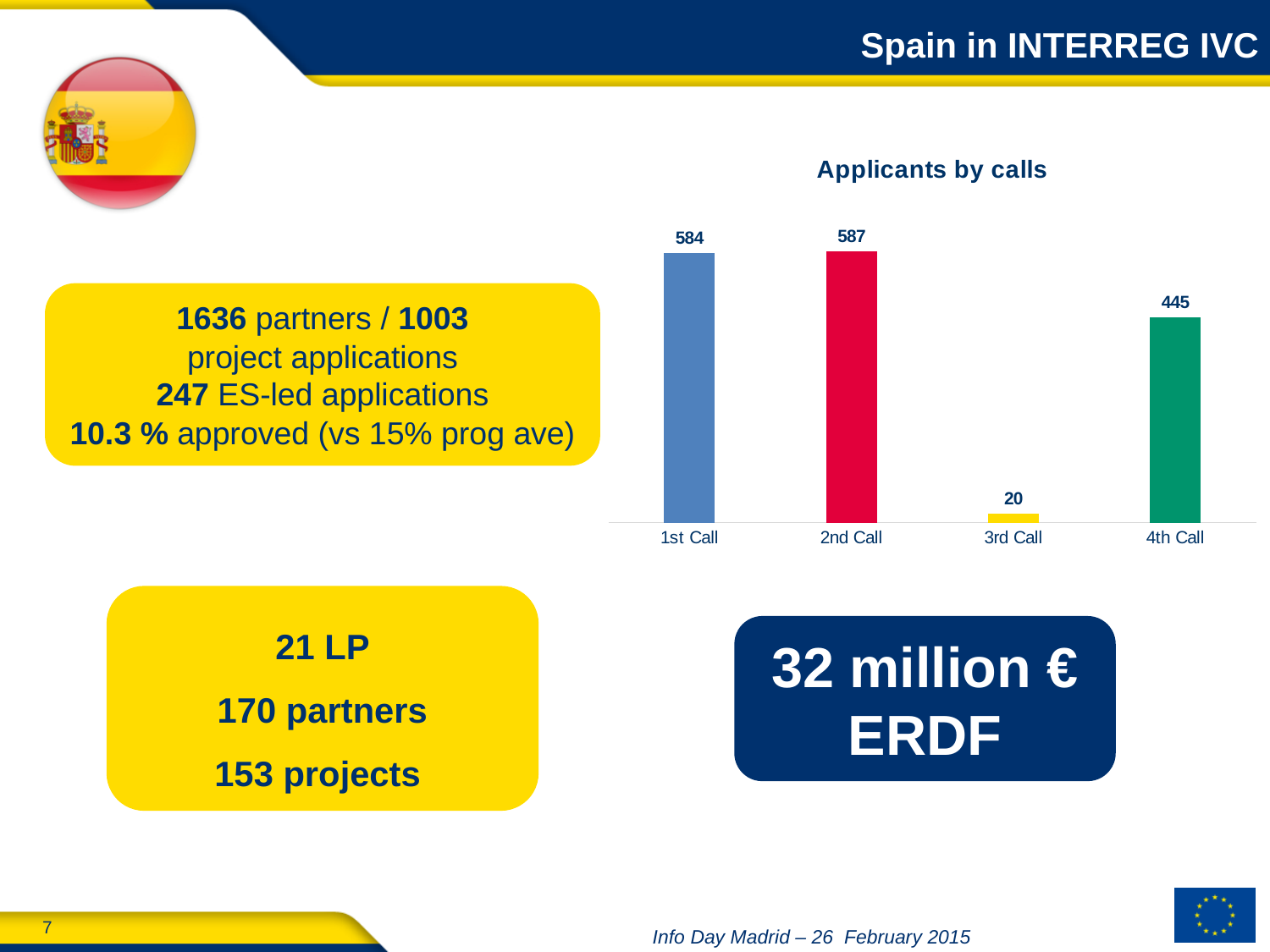
Which is larger, the value for 1st Call or the value for 4th Call? 1st Call Which call has the highest number of applicants? 2nd Call What is the value for 2nd Call in the Applicants by calls chart? 587 What is the title of the chart on the slide? Applicants by calls What is the difference between the 1st Call and 3rd Call values? 564 How many calls are shown in the Applicants by calls chart? 4 What is the difference between the 2nd Call and 4th Call values? 142 What is the value for 4th Call in the Applicants by calls chart? 445 What is the value for 3rd Call in the Applicants by calls chart? 20 What is the value for 1st Call in the Applicants by calls chart? 584 What kind of chart is the Applicants by calls chart? bar chart Which call has the lowest number of applicants? 3rd Call